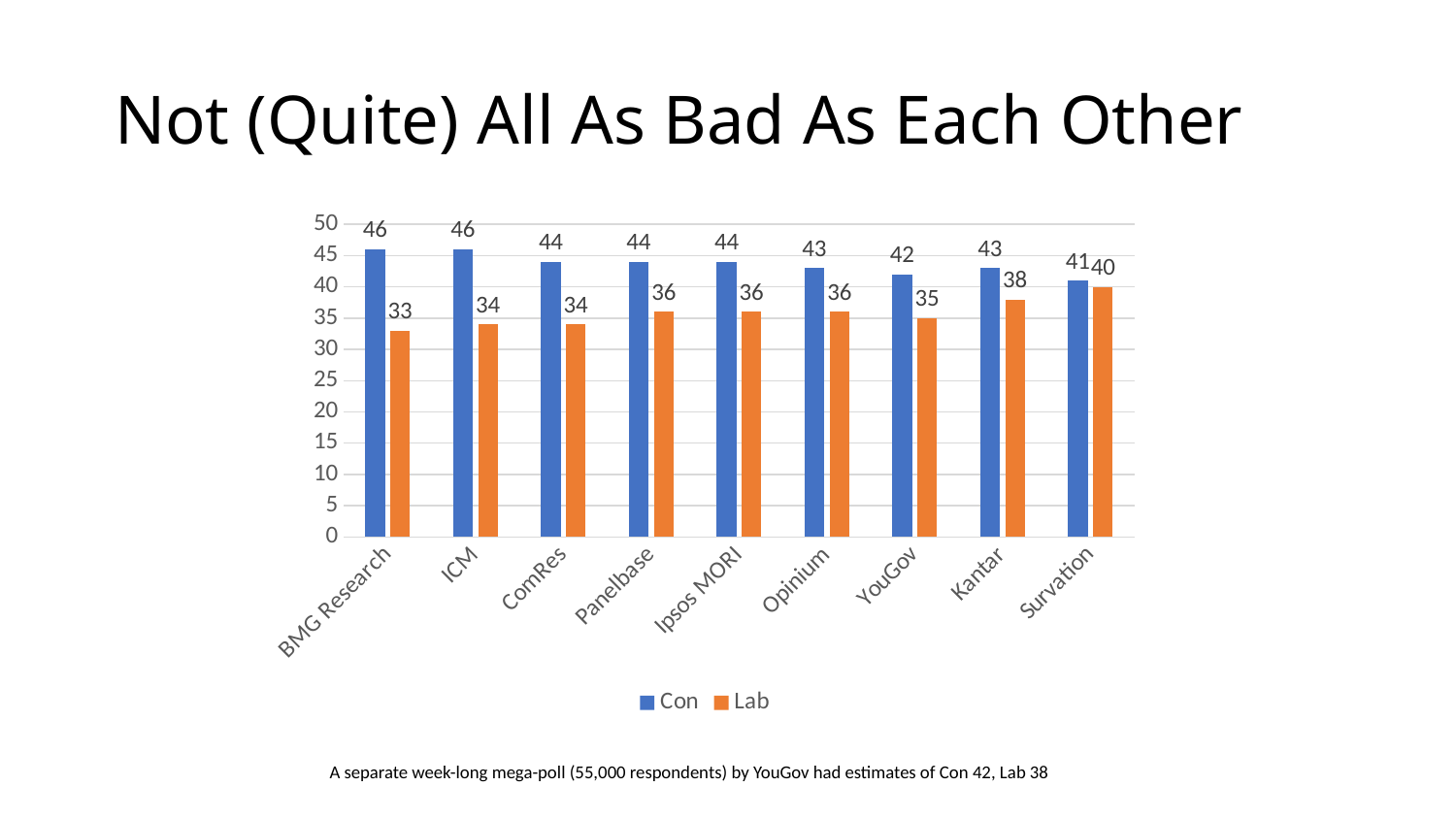
What is the Lab value for BMG Research? 33 Which is larger for YouGov, the Con value or the Lab value? Con What is the difference between the Con and Lab values for ICM? 12 How many pollsters are shown on the x axis? 9 How many series does the legend list? 2 Which pollster shows the lowest Con value? Survation What kind of chart is shown on the slide? Bar chart Which pollster shows the highest Lab value? Survation What is the Con value for Kantar? 43 What is the Lab value for Survation? 40 Which pollster shows the lowest Lab value? BMG Research What is the difference between the Con and Lab values for Survation? 1